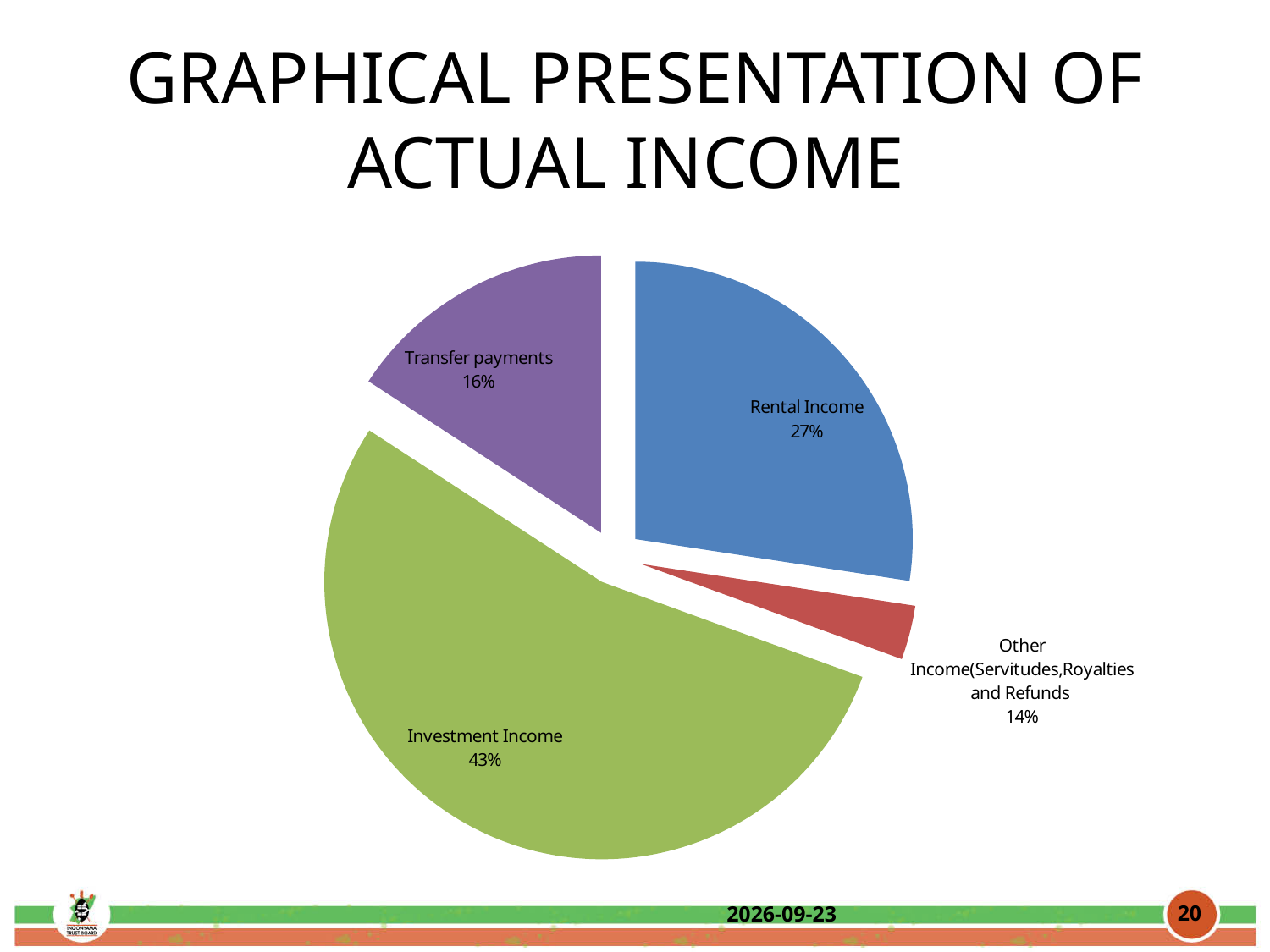
What is the difference in percentage points between Investment Income and Rental Income? 16 Which is larger, Rental Income or Transfer payments? Rental Income What percentage of actual income is Investment Income? 43% What is the combined share of Rental Income and Transfer payments? 43% What type of chart is shown on the slide? pie chart How many slices does the pie chart have? 4 What is the title of the slide containing the pie chart? GRAPHICAL PRESENTATION OF ACTUAL INCOME What percentage of actual income is Rental Income? 27% What percentage of actual income is Other Income (Servitudes, Royalties and Refunds)? 14% Which income category has the largest share of the pie? Investment Income What percentage of actual income is Transfer payments? 16% Which income category has the smallest share of the pie? Other Income(Servitudes,Royalties and Refunds)